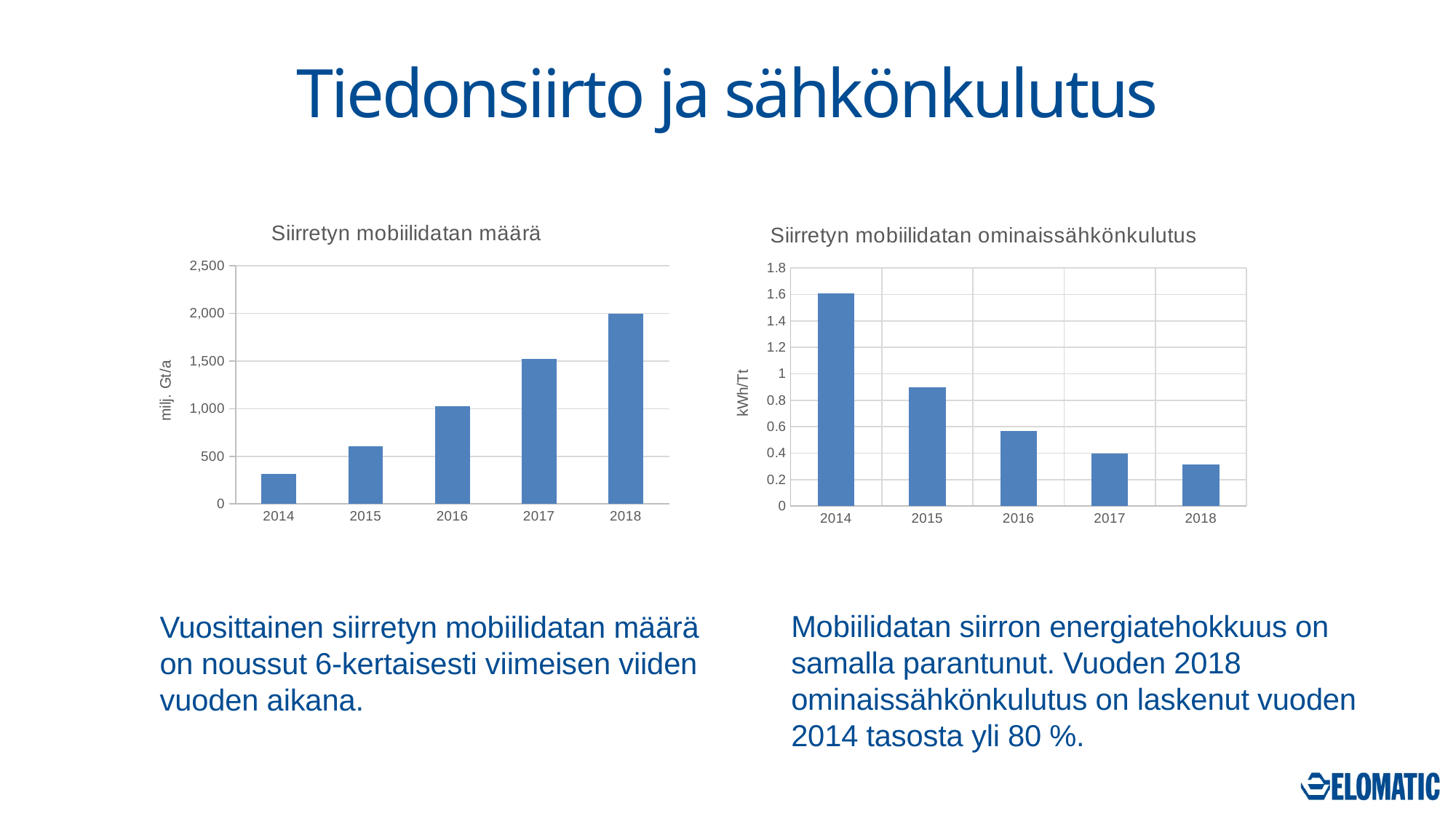
What is the y-axis unit label on the chart titled "Siirretyn mobiilidatan ominaissähkönkulutus"? kWh/Tt In the chart titled "Siirretyn mobiilidatan ominaissähkönkulutus", which year has the highest value? 2014 What kind of chart is the chart titled "Siirretyn mobiilidatan ominaissähkönkulutus"? bar chart In the chart titled "Siirretyn mobiilidatan ominaissähkönkulutus", do the values rise or fall from 2014 to 2018? fall In the chart titled "Siirretyn mobiilidatan määrä", is the value for 2014 greater or less than 500? less In the chart titled "Siirretyn mobiilidatan määrä", which year has the highest value? 2018 In the chart titled "Siirretyn mobiilidatan määrä", which year has the lowest value? 2014 In the chart titled "Siirretyn mobiilidatan ominaissähkönkulutus", which year has the lowest value? 2018 How many years are shown in the chart titled "Siirretyn mobiilidatan määrä"? 5 In the chart titled "Siirretyn mobiilidatan määrä", do the values rise or fall from 2014 to 2018? rise In the chart titled "Siirretyn mobiilidatan määrä", is the value for 2018 greater or less than 1,500? greater In the chart titled "Siirretyn mobiilidatan ominaissähkönkulutus", is the value for 2015 greater or less than 0.8? greater